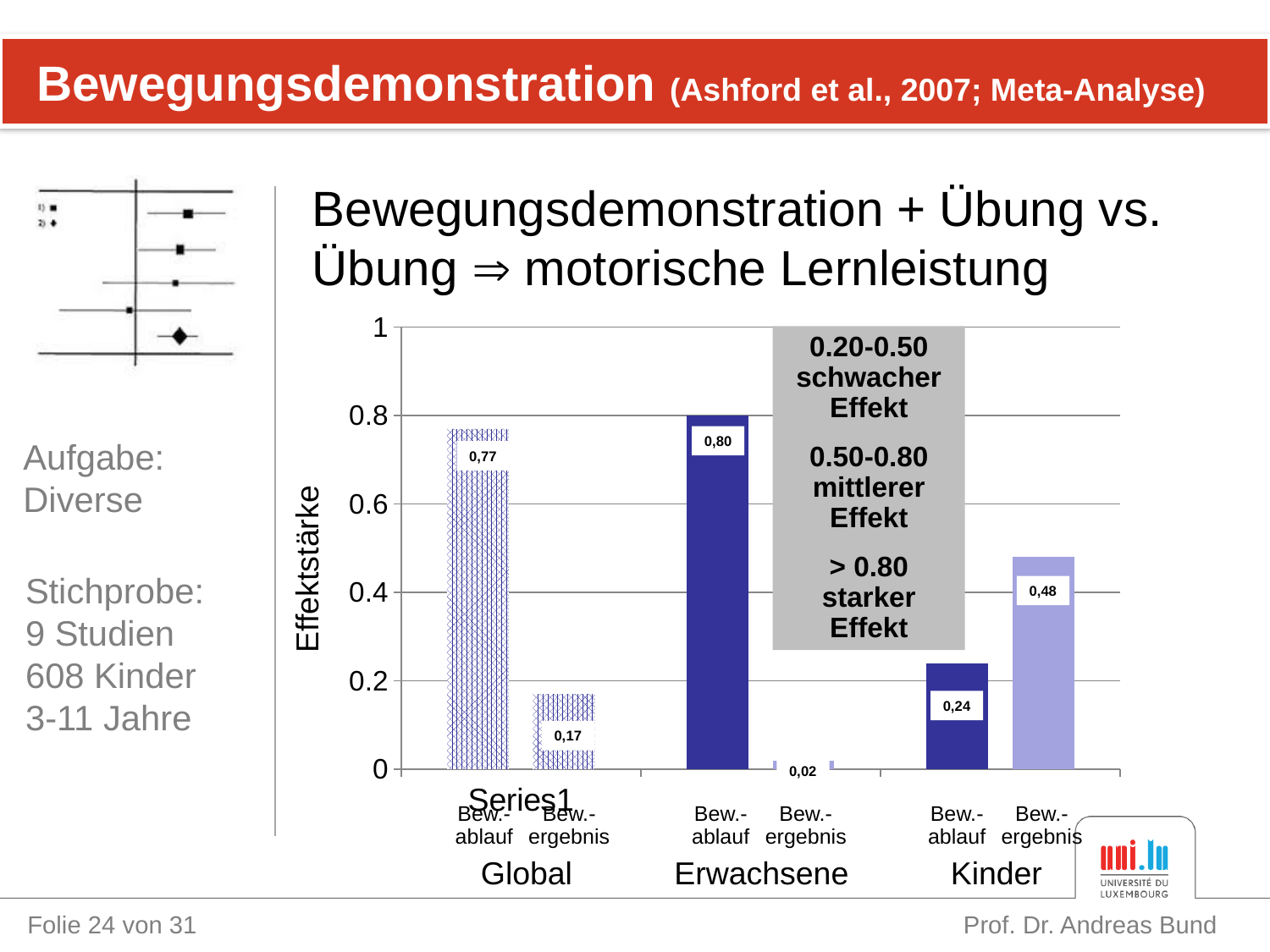
What is the value for Bew.-ablauf in the Kinder group? 0,24 Is the value for Bew.-ablauf in the Erwachsene group greater or less than 0.6? greater What is the value for Bew.-ablauf in the Global group? 0,77 How many bars are plotted in the chart? 6 Which bar has the highest value in the chart? Bew.-ablauf (Erwachsene), 0,80 Which bar has the lowest value in the chart? Bew.-ergebnis (Erwachsene), 0,02 What is the value for Bew.-ergebnis in the Erwachsene group? 0,02 In the Kinder group, which is larger: Bew.-ablauf or Bew.-ergebnis? Bew.-ergebnis What is the label of the y axis of the chart? Effektstärke What kind of chart is shown on the slide? bar chart What is the difference between Bew.-ablauf and Bew.-ergebnis in the Global group? 0,60 What is the value for Bew.-ergebnis in the Kinder group? 0,48